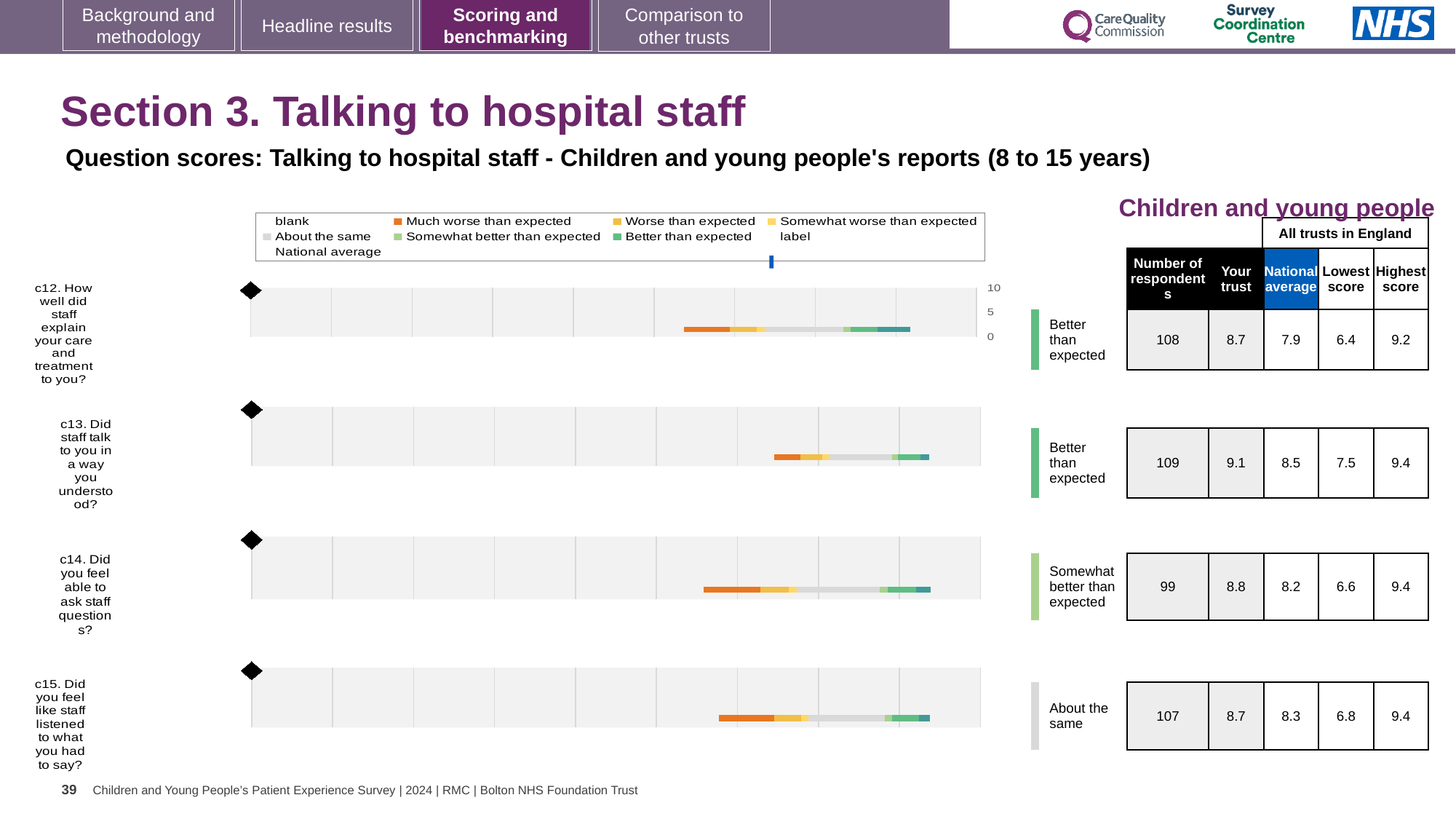
How many respondents answered c14 (Did you feel able to ask staff questions?)? 99 Which question has the lowest number of respondents? c14 What is the 'Your trust' score for c13 (Did staff talk to you in a way you understood?)? 9.1 What benchmark category is shown for c14 (Did you feel able to ask staff questions?)? Somewhat better than expected What kind of chart is used to show the question scores for c12 to c15? bar chart What colour in the legend represents 'Much worse than expected'? orange What is the difference between the 'Your trust' score and the national average for c13? 0.6 What is the highest score across all trusts in England for c15 (Did you feel like staff listened to what you had to say?)? 9.4 What is the national average score for c12 (How well did staff explain your care and treatment to you?)? 7.9 Which question has the highest 'Your trust' score? c13 How many questions (c12 to c15) are plotted on the slide? 4 For c12, which is larger: the 'Your trust' score or the national average? Your trust